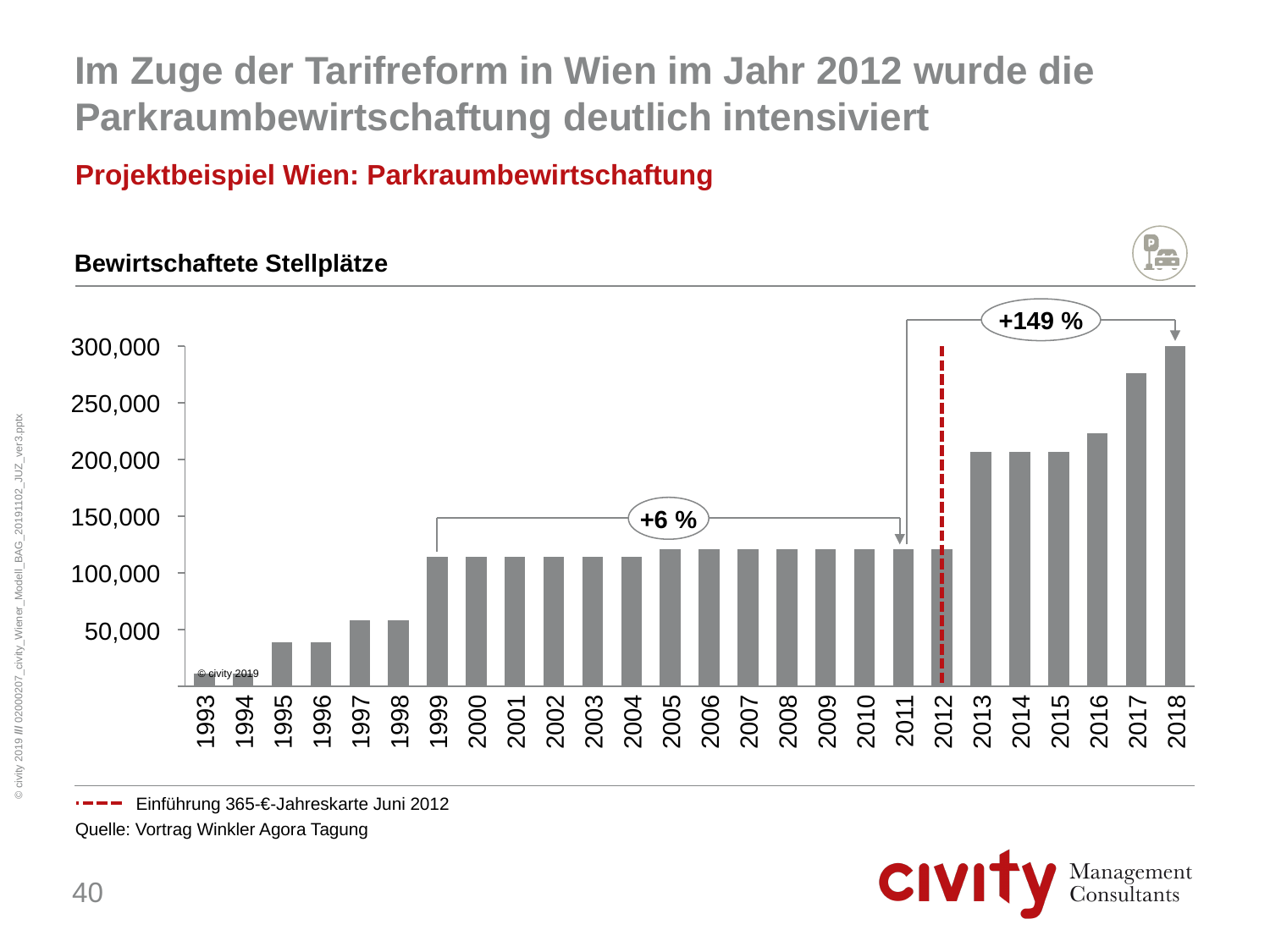
Is the value for 1995 greater or less than 50,000? less What percentage change is annotated between 2012 and 2018? +149 % Is the value for 2017 greater or less than 250,000? greater Do the values generally rise or fall from 1993 to 2018? rise What does the red dashed line at 2012 mark according to the legend? Einführung 365-€-Jahreskarte Juni 2012 Is the value for 1999 greater or less than 100,000? greater Which year has the highest number of Bewirtschaftete Stellplätze? 2018 Which year has the larger value, 2015 or 2016? 2016 What kind of chart is shown on the slide? bar chart How many years are shown on the x axis of the chart? 26